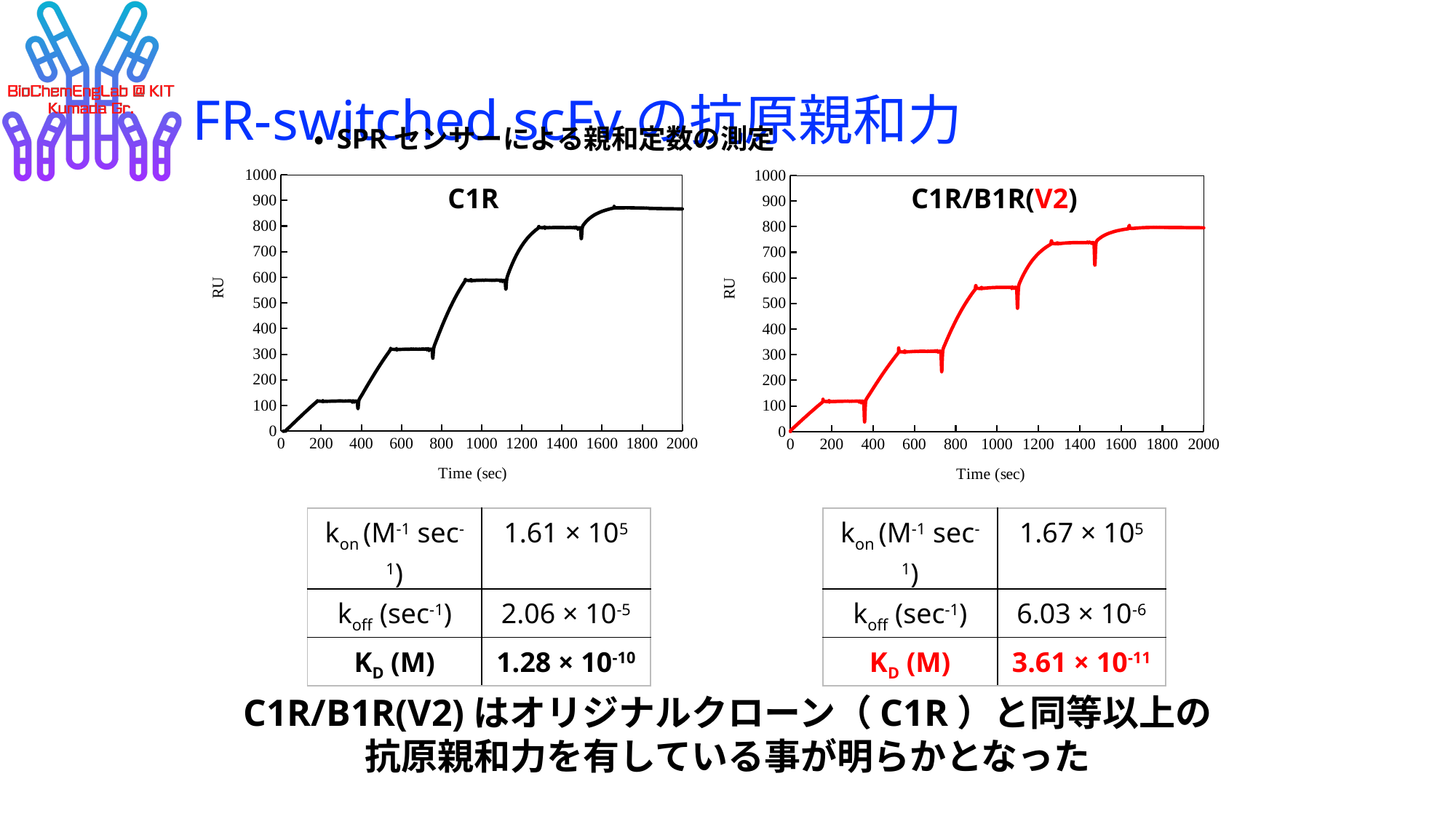
In the C1R chart, is the RU value at 1000 sec greater or less than 500? greater What is the label of the y-axis in the C1R chart? RU In the C1R chart, is the RU value at 2000 sec greater or less than 800? greater In the C1R chart, does the RU value generally rise or fall as time increases? rise In the C1R/B1R(V2) chart, is the RU value at 200 sec greater or less than 200? less What is the highest tick value shown on the x-axis of the C1R chart? 2000 In the C1R/B1R(V2) chart, does the RU value generally rise or fall along the time axis? rise Which chart reaches a higher final RU value at 2000 sec, C1R or C1R/B1R(V2)? C1R What is the highest tick value shown on the y-axis of the C1R/B1R(V2) chart? 1000 What is the label of the x-axis in the C1R/B1R(V2) chart? Time (sec) What kind of chart is the C1R chart on the left? line chart